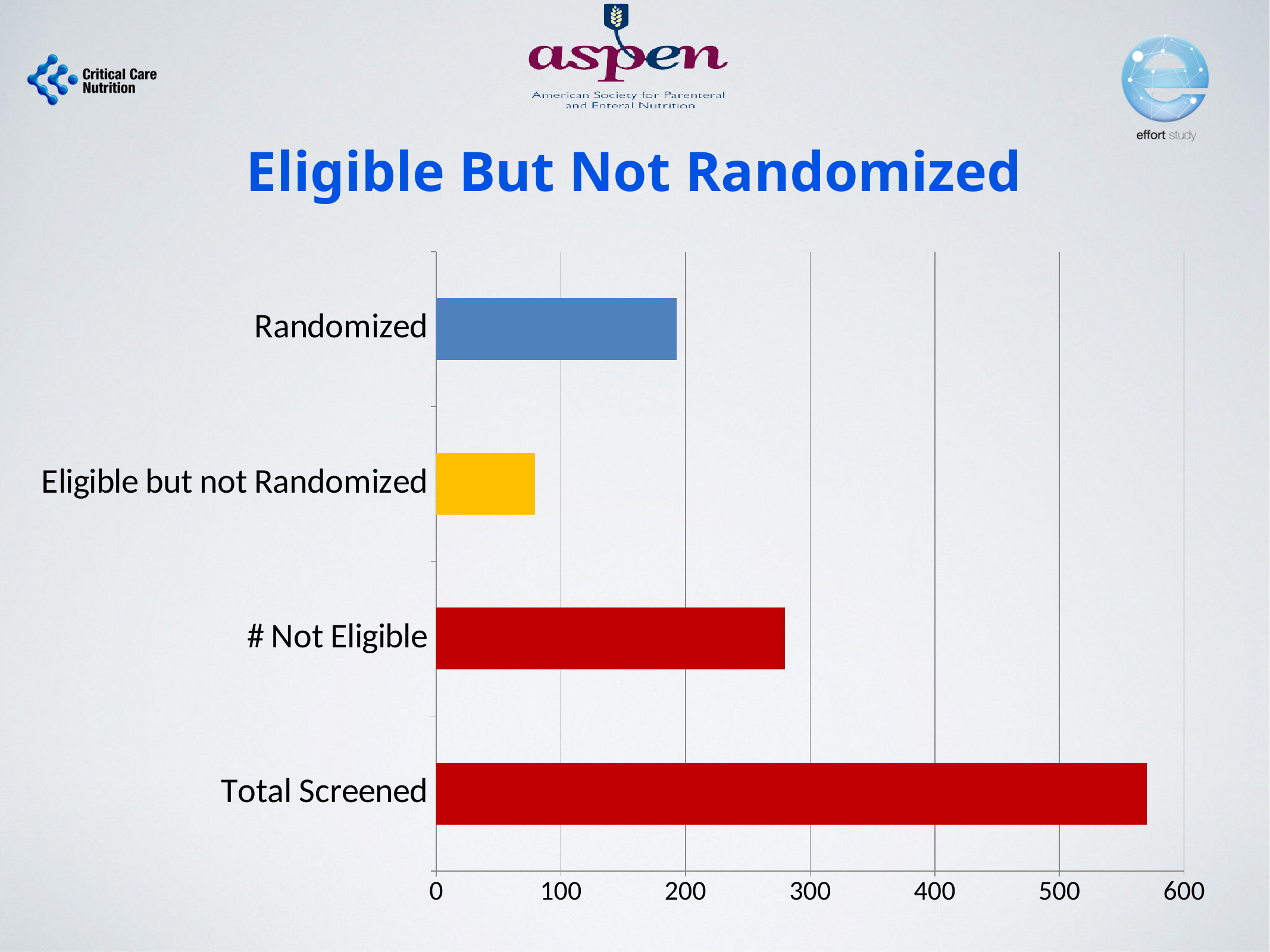
Which is larger, the value for Randomized or the value for # Not Eligible? # Not Eligible Is the value for Total Screened greater or less than 500? greater Is the value for Eligible but not Randomized greater or less than 100? less Is the value for Total Screened greater or less than 600? less How many categories are plotted in the chart? 4 What is the title of the chart on the slide? Eligible But Not Randomized Which category has the lowest value? Eligible but not Randomized Which category has the highest value? Total Screened What kind of chart is shown on the slide? bar chart